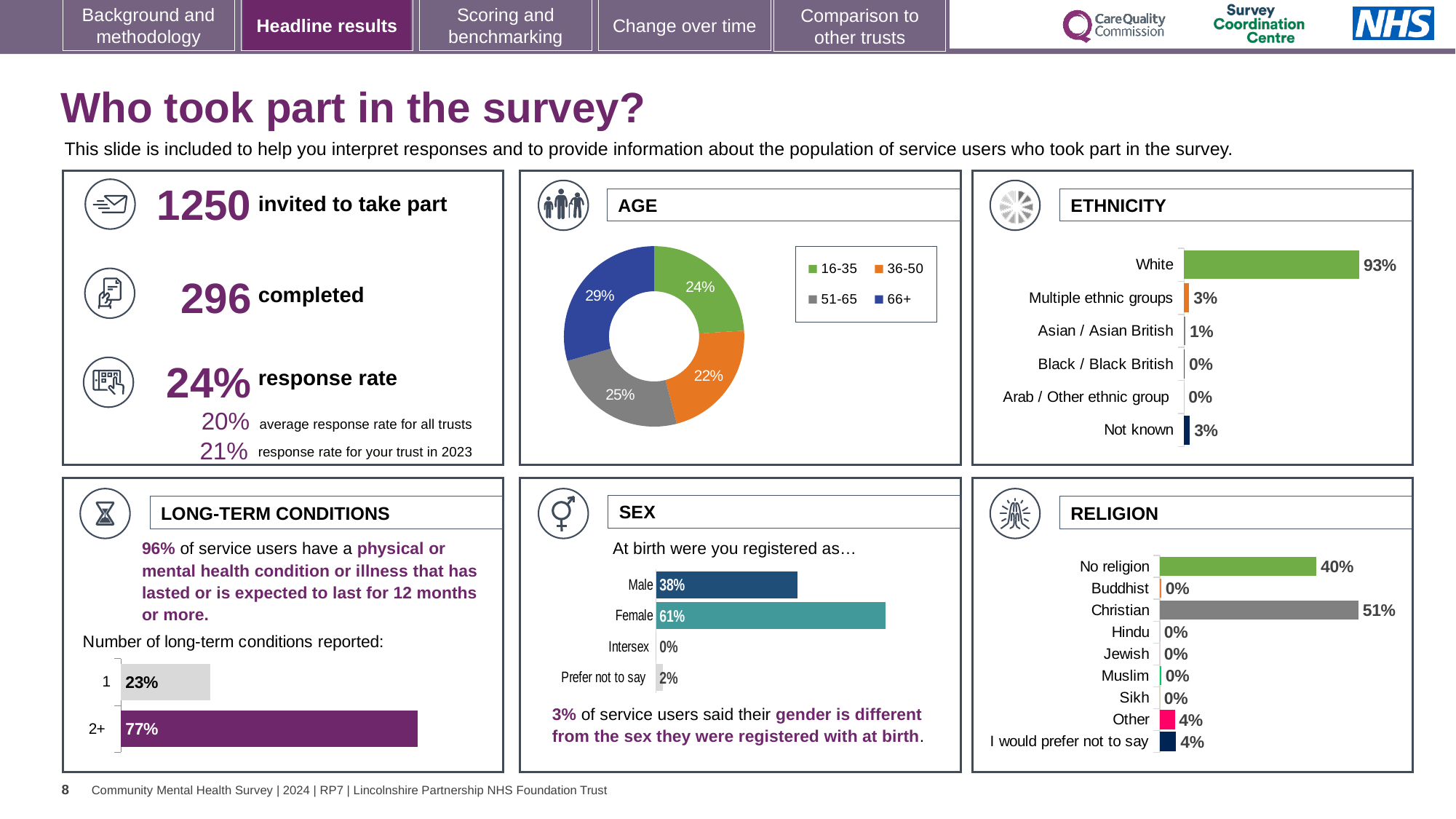
In the LONG-TERM CONDITIONS chart, what percentage of service users reported 2+ long-term conditions? 77% In the SEX chart, which is larger, Male or Female? Female In the SEX chart, what is the value for Female? 61% In the AGE chart, which age group has the smallest share? 36-50 In the RELIGION chart, which category has the highest value? Christian In the ETHNICITY chart, what is the difference between White and Multiple ethnic groups? 90% In the ETHNICITY chart, what is the value for White? 93% In the AGE chart, what percentage of respondents were aged 66+? 29% How many age groups does the legend of the AGE chart list? 4 In the ETHNICITY chart, how many ethnic categories are shown? 6 What kind of chart is the AGE chart? Donut (pie) chart In the RELIGION chart, what is the difference between Christian and No religion? 11%